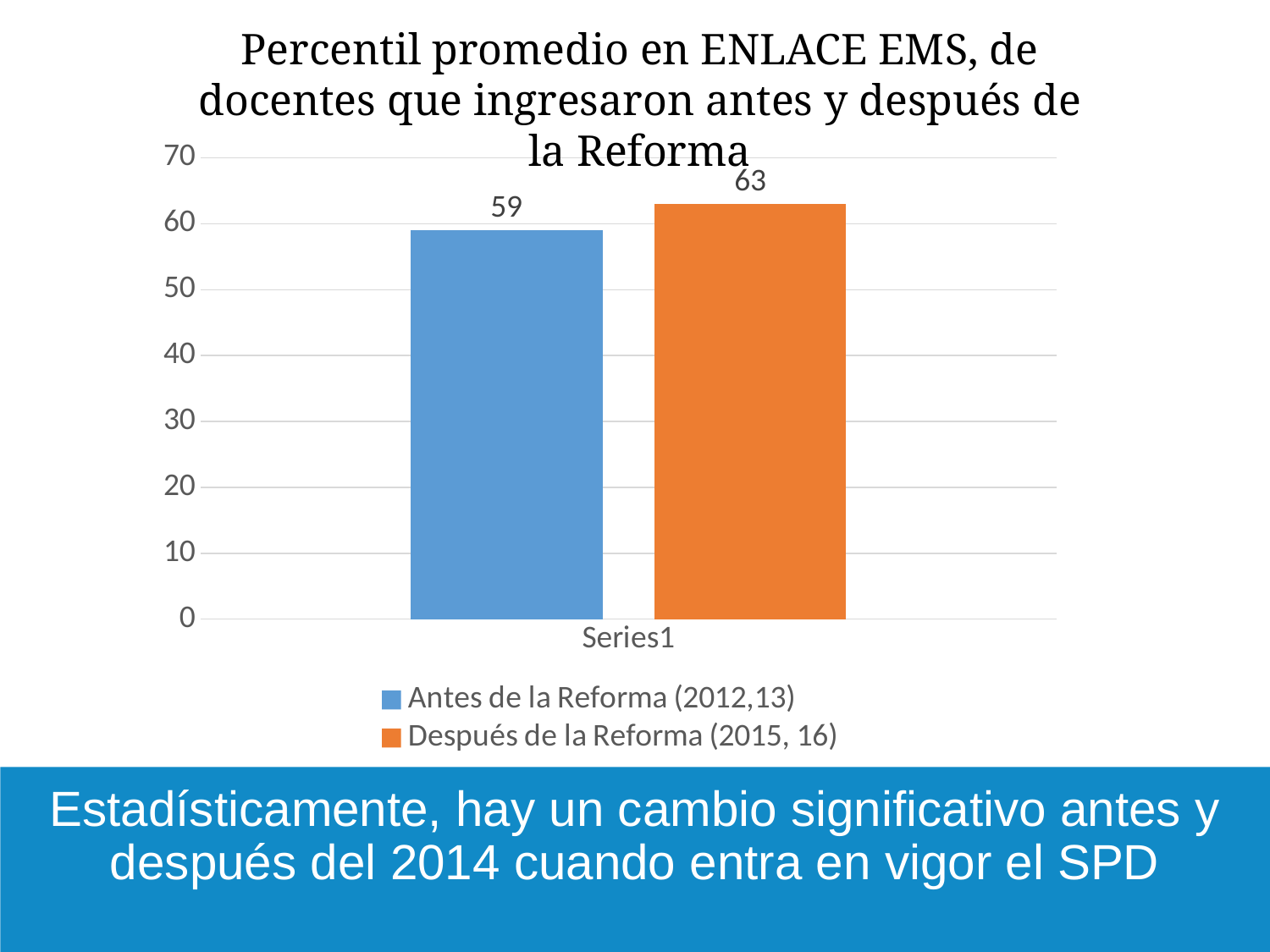
Is the value for Antes de la Reforma (2012,13) greater or less than 60? less What is the title of the chart? Percentil promedio en ENLACE EMS, de docentes que ingresaron antes y después de la Reforma What is the difference between the Después de la Reforma value and the Antes de la Reforma value? 4 Is the value for Después de la Reforma (2015, 16) greater or less than 60? greater Which series has the higher value? Después de la Reforma (2015, 16) Which series has the lower value? Antes de la Reforma (2012,13) What is the value for Antes de la Reforma (2012,13)? 59 What is the value for Después de la Reforma (2015, 16)? 63 What colour is the bar for Después de la Reforma (2015, 16)? orange What kind of chart is shown? bar chart Is the value for Antes de la Reforma (2012,13) larger or smaller than the value for Después de la Reforma (2015, 16)? smaller How many series does the legend list? 2